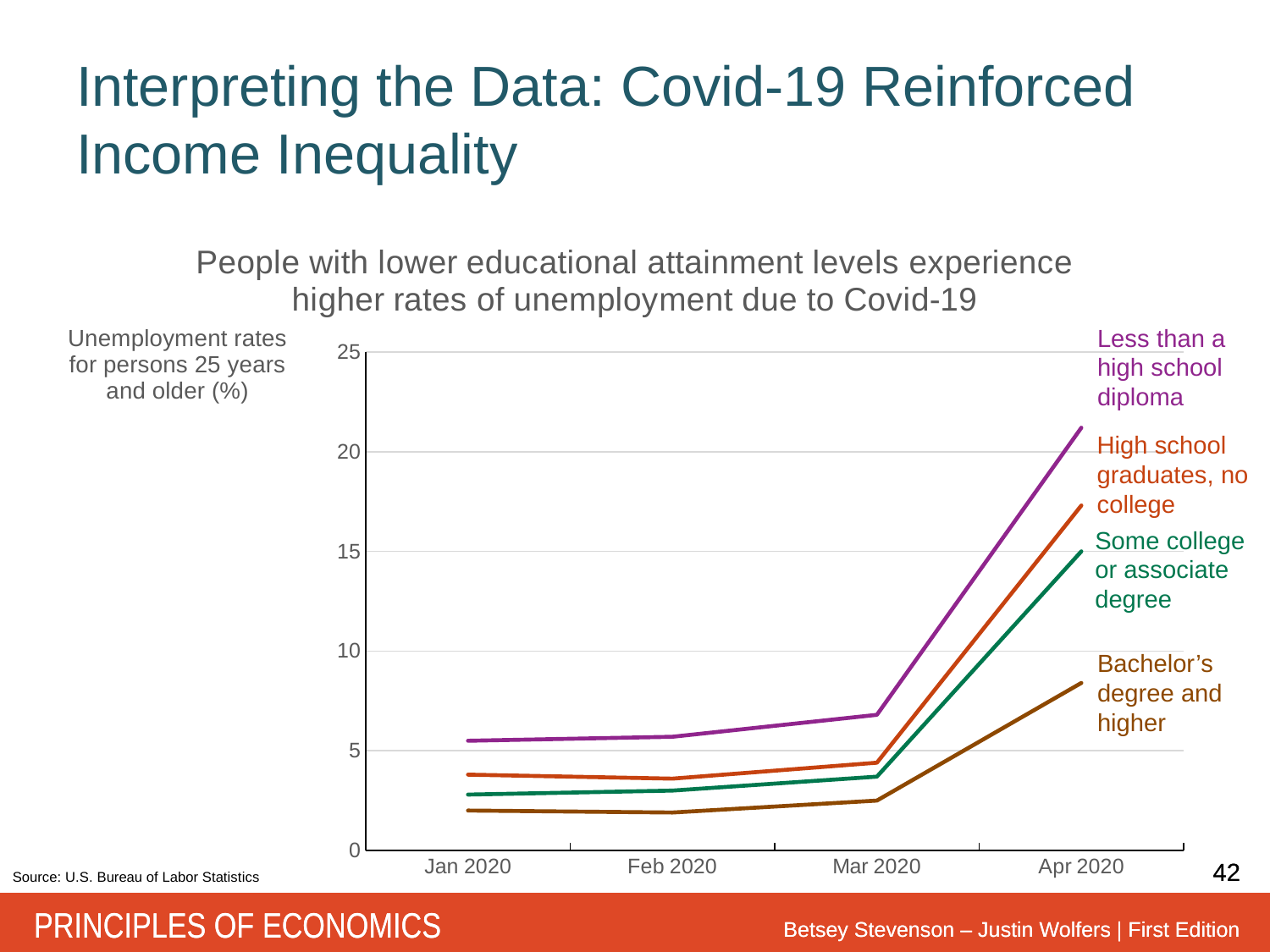
Is the Apr 2020 unemployment rate for people with a bachelor's degree and higher greater or less than 10? less Is the Jan 2020 unemployment rate for people with less than a high school diploma greater or less than 5? greater What kind of chart is shown on the slide? line chart What is the source of the data cited on the slide? U.S. Bureau of Labor Statistics How many months are shown along the x axis of the chart? 4 Is the Apr 2020 unemployment rate for people with less than a high school diploma greater or less than 20? greater Which educational attainment group has the highest unemployment rate in Apr 2020? Less than a high school diploma How many series (educational attainment groups) are plotted on the chart? 4 Does the unemployment rate for people with less than a high school diploma rise or fall from Jan 2020 to Apr 2020? rise In Apr 2020, which group has the higher unemployment rate: high school graduates with no college, or those with some college or associate degree? High school graduates, no college Which educational attainment group has the lowest unemployment rate in Apr 2020? Bachelor's degree and higher